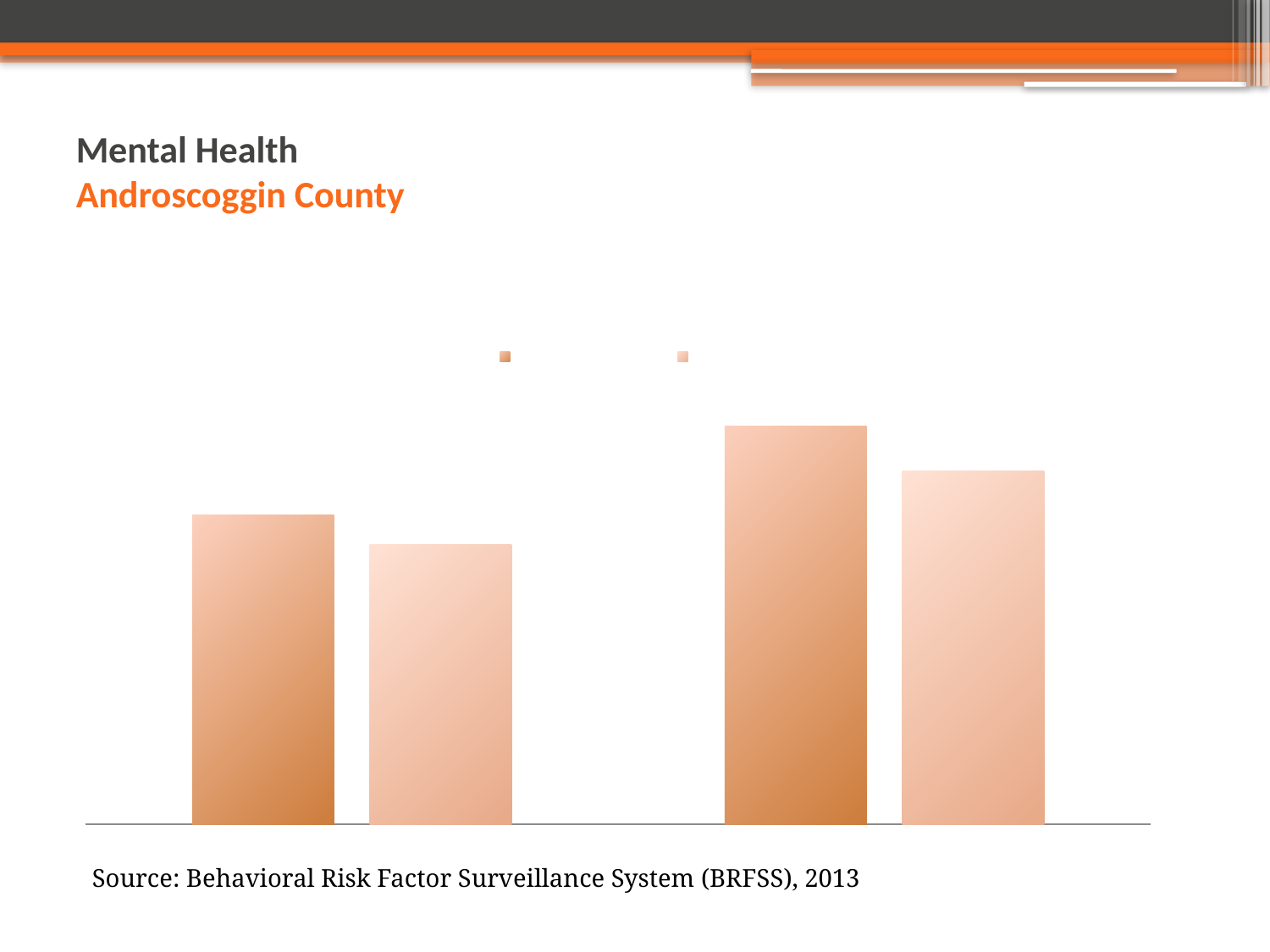
Which bar is the shortest in the chart: the first, second, third or fourth from the left? second Which bar is the tallest in the chart: the first, second, third or fourth from the left? third Is the third bar from the left taller or shorter than the fourth bar? taller Is the right-hand group of bars taller or shorter than the left-hand group? taller Is the leftmost bar taller or shorter than the second bar from the left? taller How many groups of bars (categories) does the chart show? 2 What kind of chart is shown on the slide? bar chart What data source is cited below the chart? Behavioral Risk Factor Surveillance System (BRFSS), 2013 How many entries does the chart's legend show? 2 Which county does the slide's chart refer to? Androscoggin County How many bars are plotted in the chart? 4